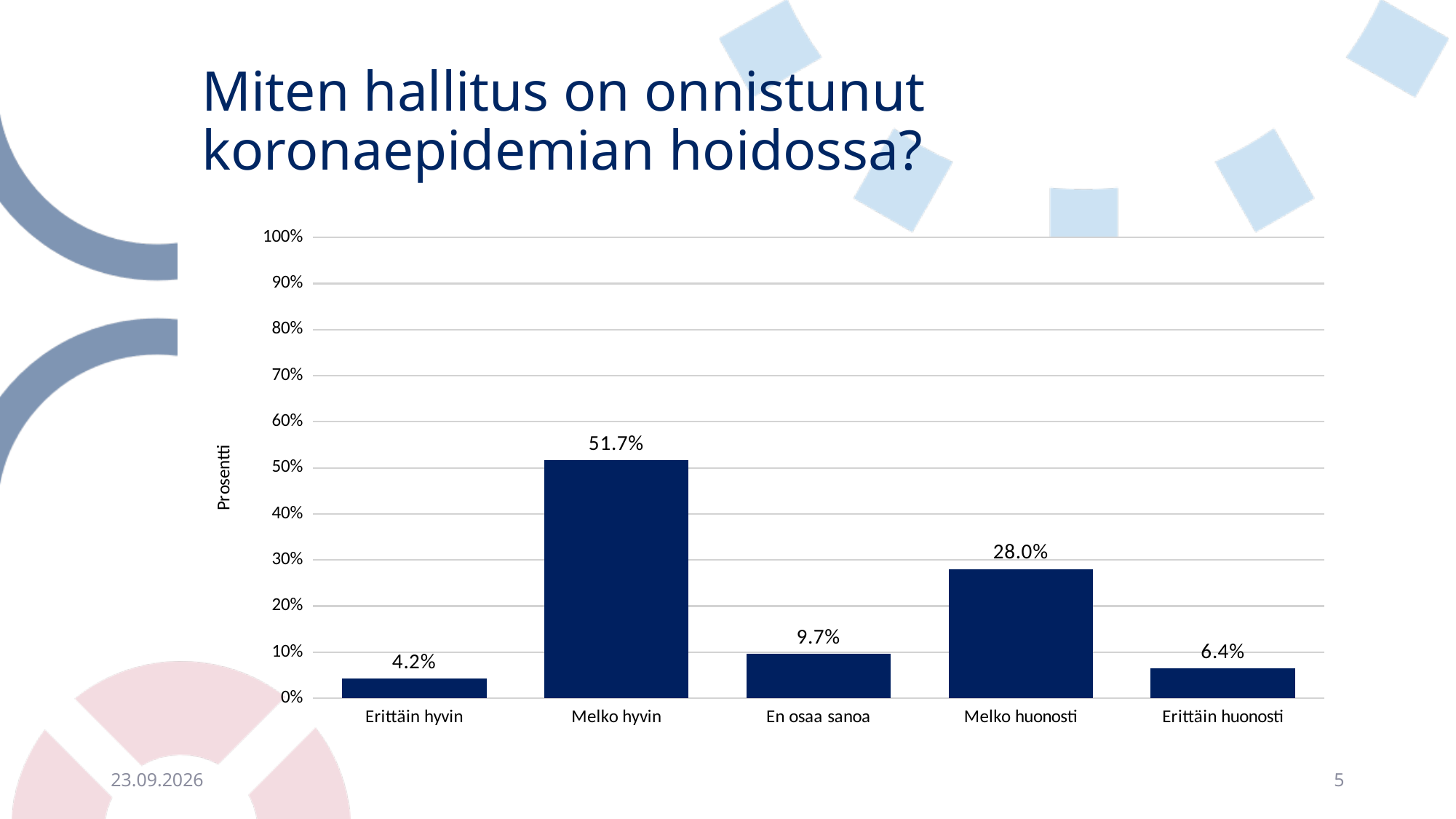
What is the value for Erittäin hyvin? 4.2% What is the value for Melko hyvin? 51.7% What is the difference between the values for Melko hyvin and Melko huonosti? 23.7% Which category has the highest value? Melko hyvin How many categories are shown on the x axis? 5 Which category has the lowest value? Erittäin hyvin What kind of chart is shown on the slide? bar chart What is the value for Melko huonosti? 28.0% Is the value for Melko huonosti greater or less than 30%? less What is the value for En osaa sanoa? 9.7% What is the label of the vertical axis? Prosentti Which is larger, the value for En osaa sanoa or the value for Erittäin huonosti? En osaa sanoa